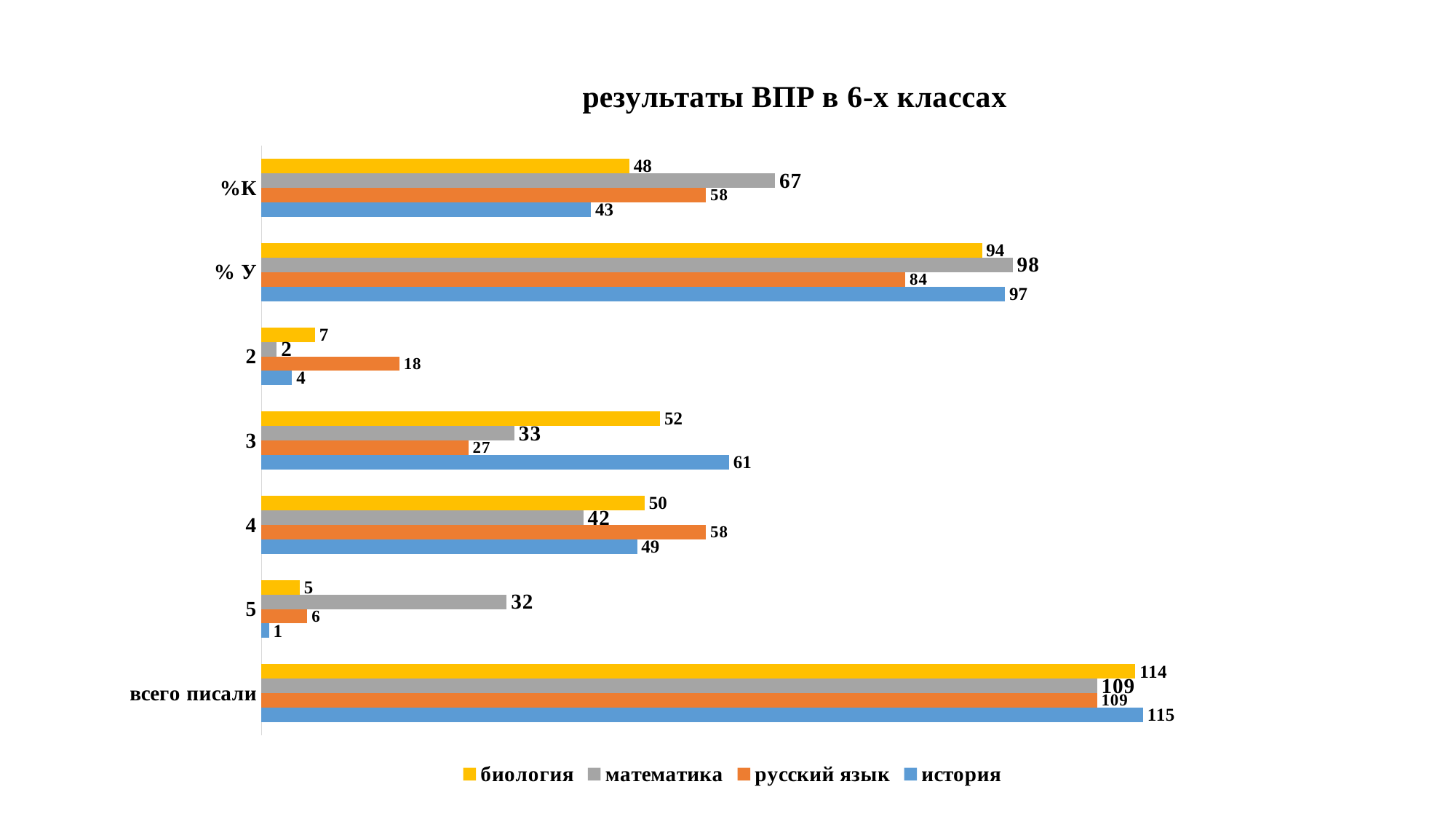
What is the value for история in the всего писали category? 115 How many series does the legend list? 4 What is the value for русский язык in category 2? 18 How many categories are shown on the vertical axis? 7 What is the difference between биология and история in category 3? 9 Which series has the highest value in category 5? математика Which colour represents история in the chart? blue Which is larger in category 4: русский язык or математика? русский язык Which series has the lowest value in the % У category? русский язык What is the title of the chart? результаты ВПР в 6-х классах What is the value for математика in the %К category? 67 What kind of chart is shown on the slide? bar chart